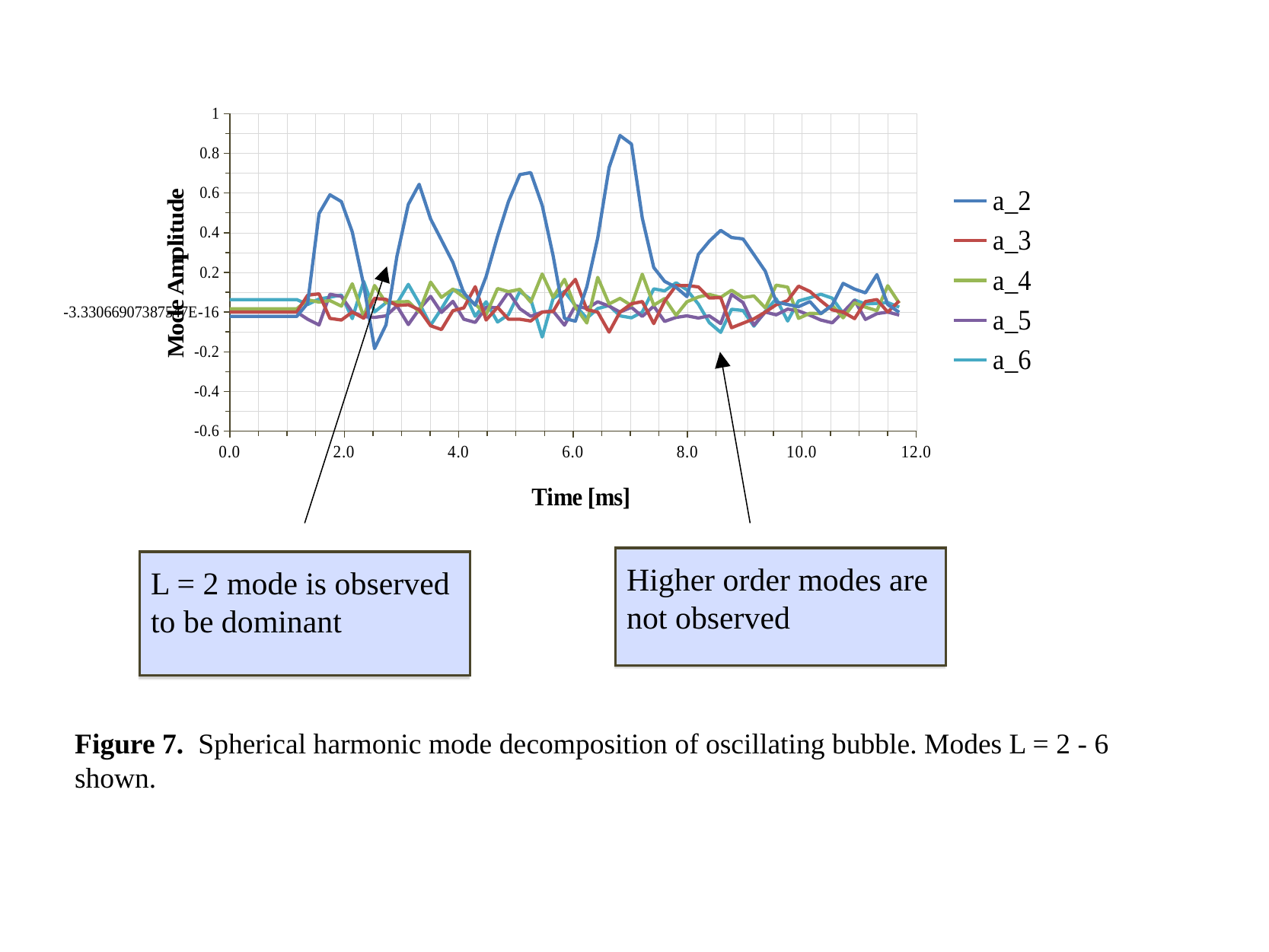
Which series reaches the highest mode amplitude on the chart? a_2 What kind of chart is shown on the slide? line chart What is the maximum value shown on the x axis? 12.0 How many series does the legend list? 5 Which series are listed in the legend? a_2, a_3, a_4, a_5, a_6 Do the values of the a_3 series ever exceed 0.4 on the chart? No Is the peak value of the a_2 series near 8.6 ms greater or less than 0.6? less Which series has the larger peak amplitude, a_2 or a_4? a_2 What is the title of the x axis? Time [ms] Is the peak value of the a_2 series near 6.8 ms greater or less than 0.8? greater